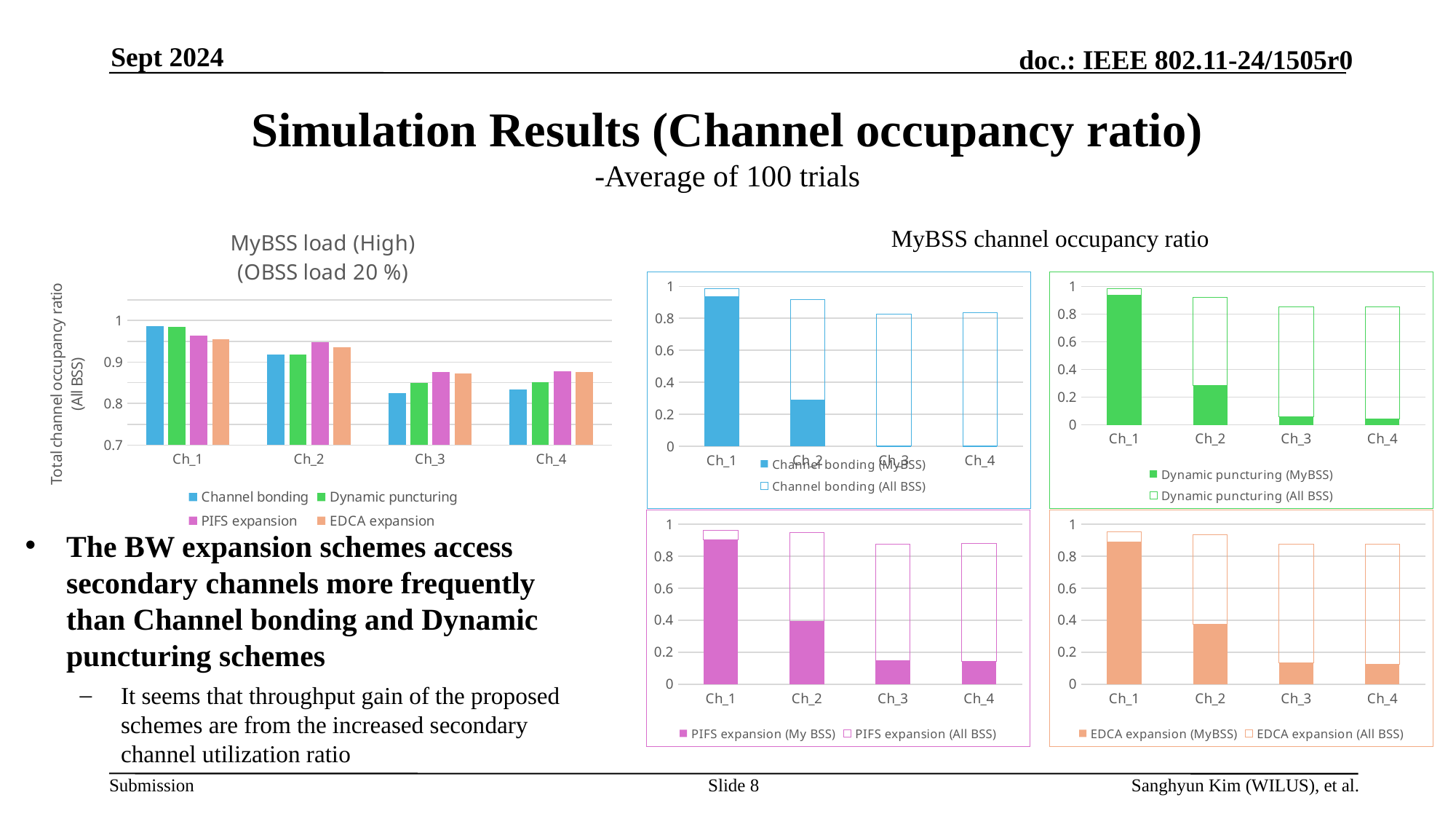
In the "MyBSS load (High) (OBSS load 20 %)" chart, is the Channel bonding value for Ch_3 greater or less than 0.9? less In the PIFS expansion chart (bottom left of the four MyBSS channel occupancy ratio charts), which is larger for PIFS expansion (My BSS): Ch_2 or Ch_3? Ch_2 How many channel categories are shown on the x axis of the "MyBSS load (High) (OBSS load 20 %)" chart? 4 In the Channel bonding chart (top left of the four MyBSS channel occupancy ratio charts), is the Channel bonding (MyBSS) value for Ch_2 greater or less than 0.4? less In the EDCA expansion chart (bottom right of the four MyBSS channel occupancy ratio charts), do the EDCA expansion (MyBSS) values rise or fall from Ch_1 to Ch_4? fall In the Dynamic puncturing chart (top right of the four MyBSS channel occupancy ratio charts), is the Dynamic puncturing (MyBSS) value for Ch_1 greater or less than 0.8? greater In the Channel bonding chart (top left of the four MyBSS channel occupancy ratio charts), which channel has the highest Channel bonding (MyBSS) value? Ch_1 What is the y-axis title of the "MyBSS load (High) (OBSS load 20 %)" chart? Total channel occupancy ratio (All BSS) What kind of chart is the "MyBSS load (High) (OBSS load 20 %)" chart on the left? bar chart In the "MyBSS load (High) (OBSS load 20 %)" chart, which is larger for Ch_2: Channel bonding or PIFS expansion? PIFS expansion How many series does the legend of the "MyBSS load (High) (OBSS load 20 %)" chart list? 4 In the "MyBSS load (High) (OBSS load 20 %)" chart, which channel has the highest Channel bonding value? Ch_1